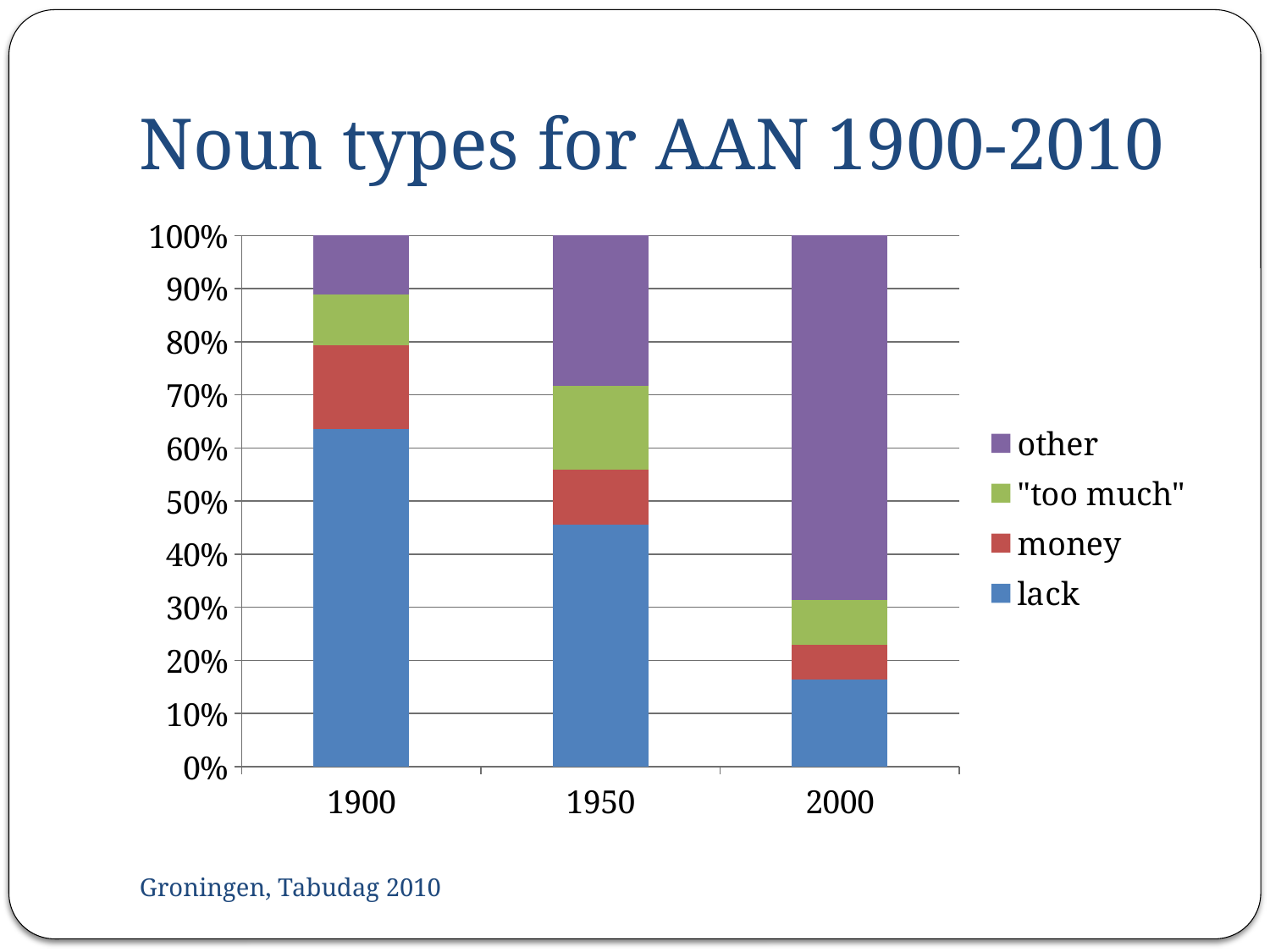
What is the total height of the 1900 stacked bar? 100% Is the share of "lack" in 2000 greater or less than 20%? less What kind of chart is shown on the slide? stacked bar chart How many years (categories) are shown on the x axis? 3 How many series does the legend list? 4 In which year is the share of "other" the largest? 2000 Which is larger, the share of "lack" in 1900 or in 2000? 1900 In which year is the share of "lack" the smallest? 2000 Does the share of "lack" rise or fall from 1900 to 2000? fall Is the share of "lack" in 1950 greater or less than 50%? less Does the share of "other" rise or fall from 1900 to 2000? rise Is the share of "lack" in 1900 greater or less than 60%? greater